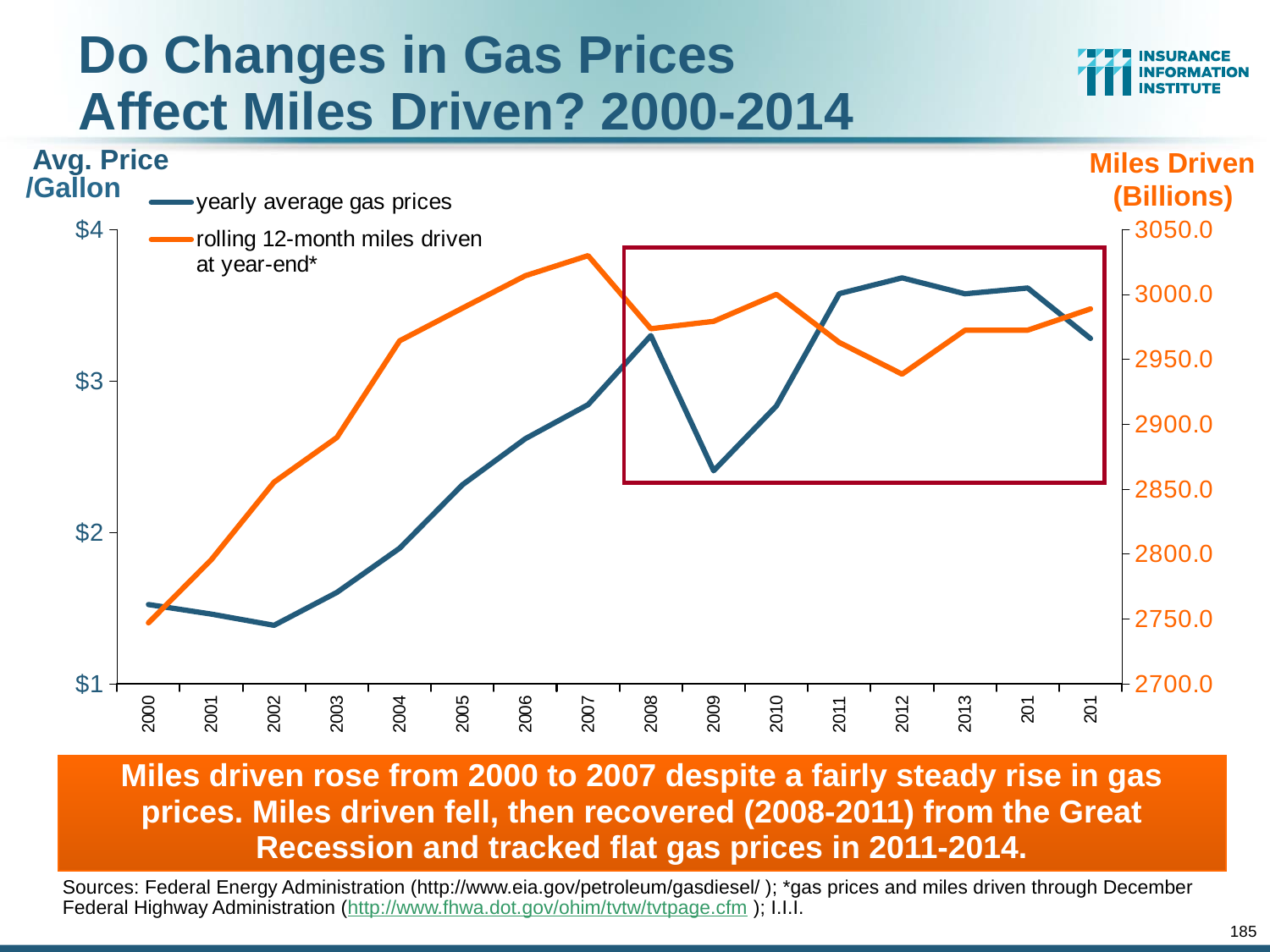
In which year does the yearly average gas price reach its highest point? 2012 What is the title of the right-hand vertical axis? Miles Driven (Billions) Is the yearly average gas price in 2009 greater or less than $3? less Does the rolling 12-month miles driven series rise or fall from 2000 to 2007? rise Is the rolling 12-month miles driven value in 2007 greater or less than 3000.0? greater In which year is the yearly average gas price at its lowest? 2002 In which year does the rolling 12-month miles driven series peak? 2007 Is the yearly average gas price in 2008 greater or less than $3? greater How many series does the chart's legend list? 2 What kind of chart is shown on the slide? line chart Which year has the higher yearly average gas price, 2008 or 2009? 2008 In which year is the rolling 12-month miles driven series at its lowest? 2000